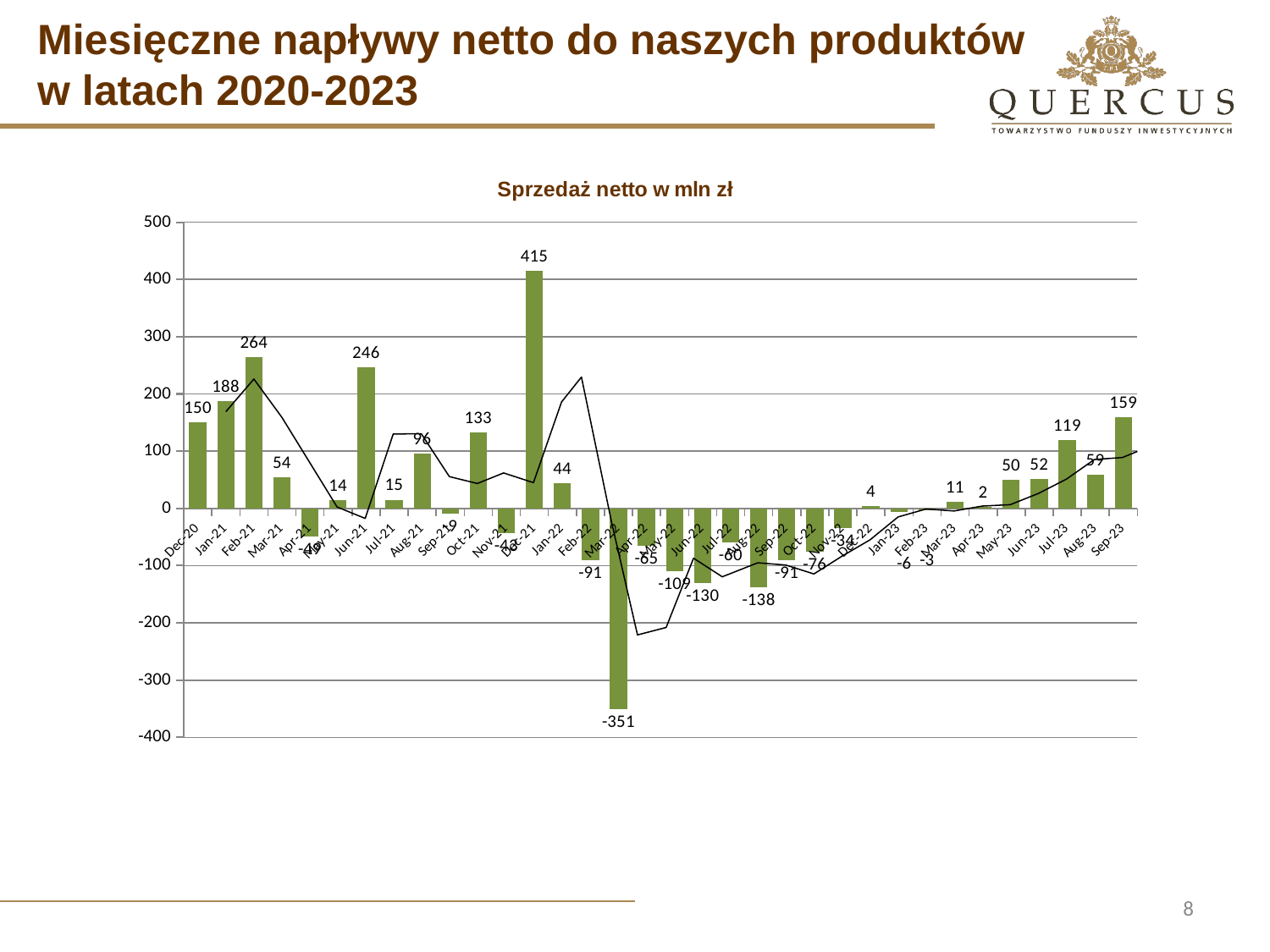
What is the value for Feb-21? 264 What is the difference between the values for Sep-23 and Jul-23? 40 What is the value for Mar-22? -351 What is the difference between the values for Aug-22 and Sep-22? 47 What is the title of the chart? Sprzedaż netto w mln zł Which month has the lowest net sales? Mar-22 What is the value for Jun-22? -130 Which month has the highest net sales? Dec-21 Is the value for Apr-21 greater or less than 0? less What kind of chart is shown on the slide? bar chart Which is larger, the value for Feb-21 or the value for Jun-21? Feb-21 What is the value for Dec-21? 415